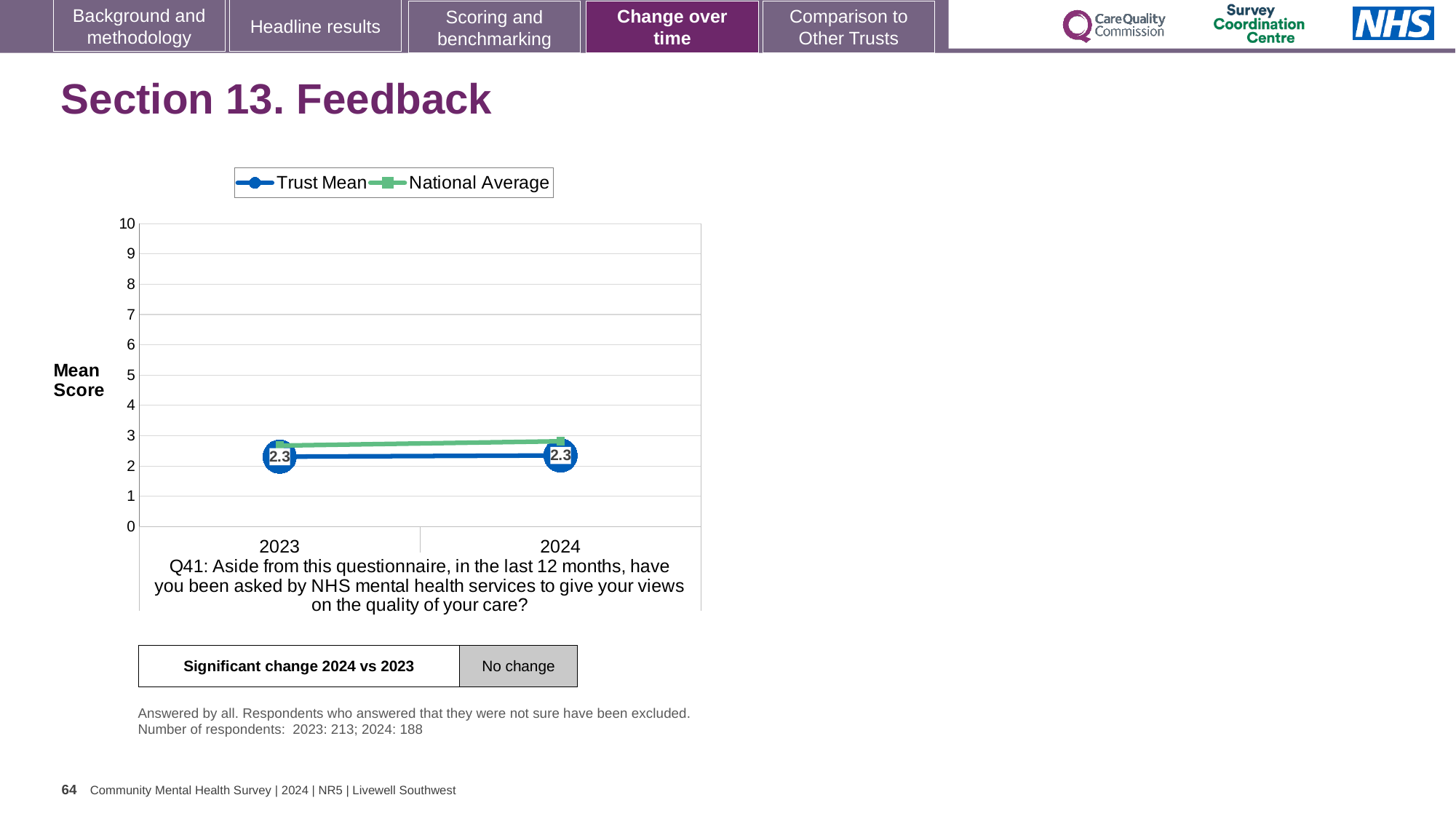
What kind of chart is shown on the slide? Line chart What is the Trust Mean value for 2024? 2.3 What is the label on the y axis of the chart? Mean Score What does the box below the chart say about the significant change 2024 vs 2023? No change Does the Trust Mean rise, fall or stay the same from 2023 to 2024? Stays the same Is the National Average value for 2024 greater or less than 5? less What is the Trust Mean value for 2023? 2.3 In 2024, which is higher: the Trust Mean or the National Average? National Average How many years are plotted on the x axis? 2 Is the National Average value for 2023 greater or less than 2? greater What is the difference between the Trust Mean in 2024 and in 2023? 0.0 How many series does the legend list? 2